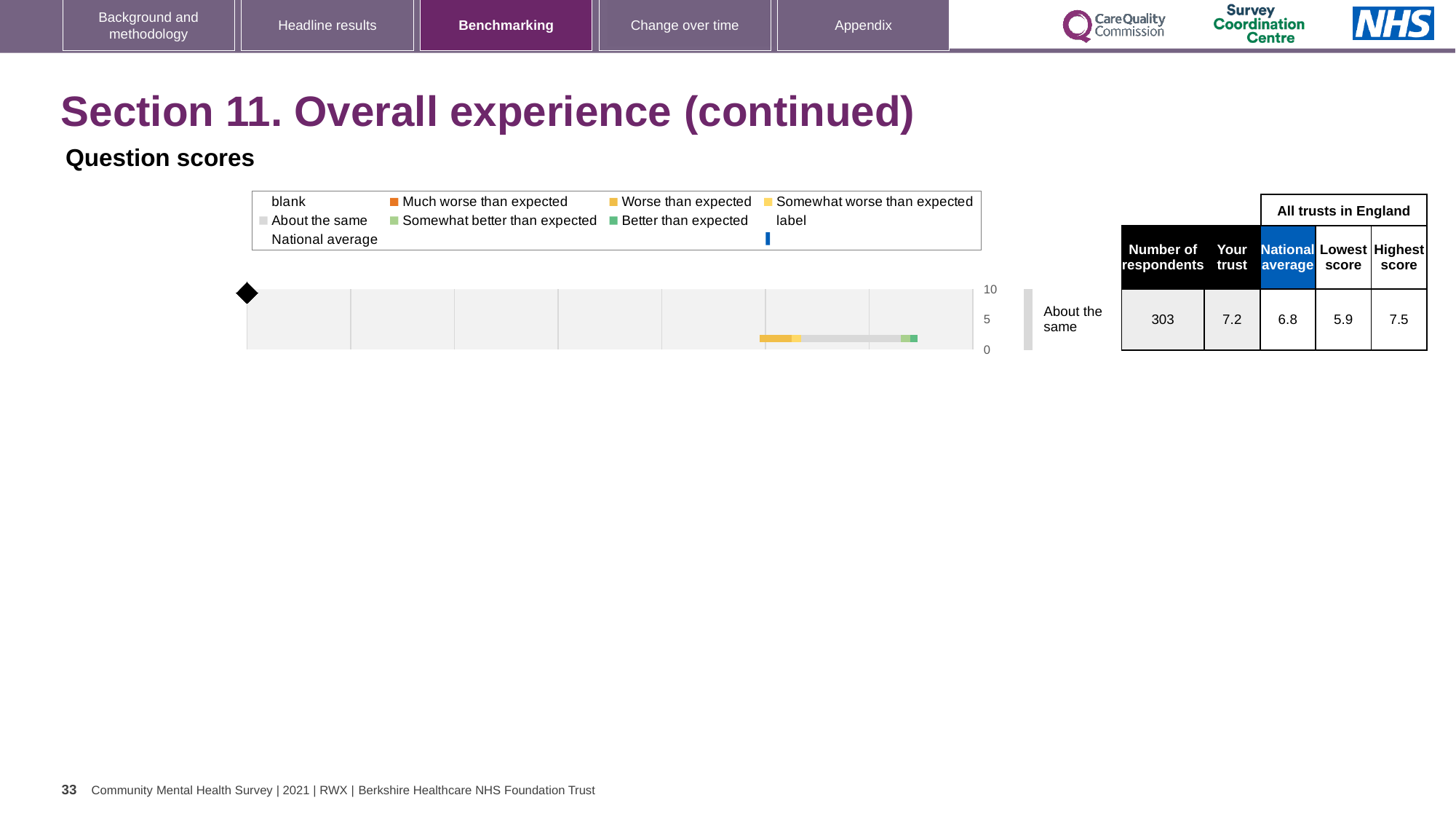
What is the difference between the 'Your trust' score and the National average score? 0.4 What is the 'Your trust' score for the 'About the same' row in the table beside the chart? 7.2 How many question categories are plotted in the chart? 1 What is the National average score shown in the table beside the chart? 6.8 What kind of chart is shown under 'Question scores'? bar chart What is the label of the single category plotted in the chart? About the same What is the Highest score among all trusts in England shown in the table? 7.5 What is the Lowest score among all trusts in England shown in the table? 5.9 What is the difference between the Highest score and the Lowest score among all trusts in England? 1.6 Which is larger, the 'Your trust' score or the National average score? Your trust What is the highest value shown on the chart's vertical axis? 10 What is the Number of respondents shown in the table beside the chart? 303